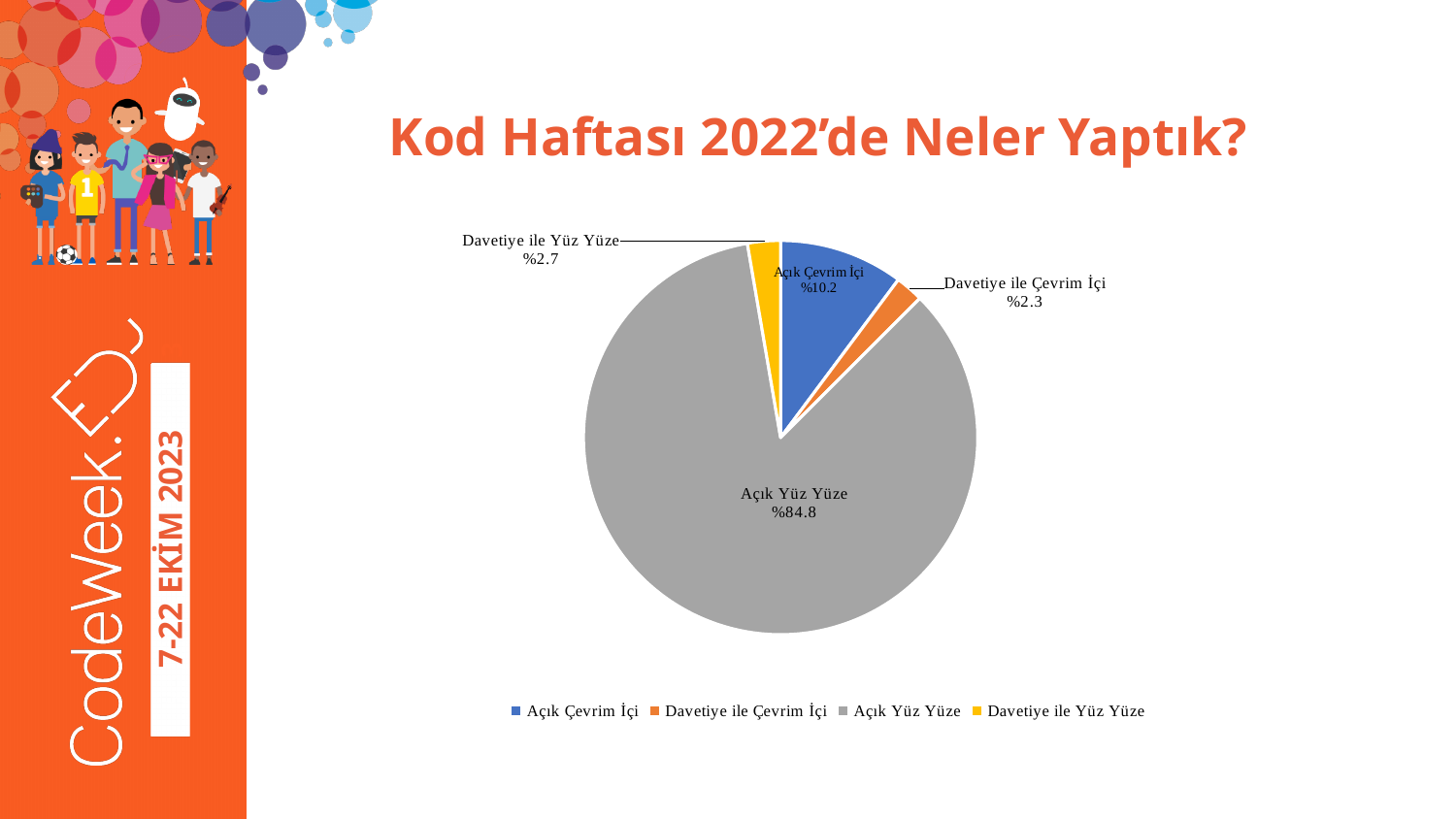
How many categories does the pie chart show? 4 What is the value for Davetiye ile Yüz Yüze? %2.7 Which category has the smallest share of the pie? Davetiye ile Çevrim İçi What is the value for Açık Yüz Yüze? %84.8 What is the difference between the values for Açık Yüz Yüze and Açık Çevrim İçi? %74.6 What kind of chart is shown on the slide? pie chart What colour is the Açık Yüz Yüze slice? grey What is the value for Açık Çevrim İçi? %10.2 What is the title of the slide containing the chart? Kod Haftası 2022'de Neler Yaptık? Which category has the largest share of the pie? Açık Yüz Yüze What is the value for Davetiye ile Çevrim İçi? %2.3 Which is larger, Açık Çevrim İçi or Davetiye ile Yüz Yüze? Açık Çevrim İçi